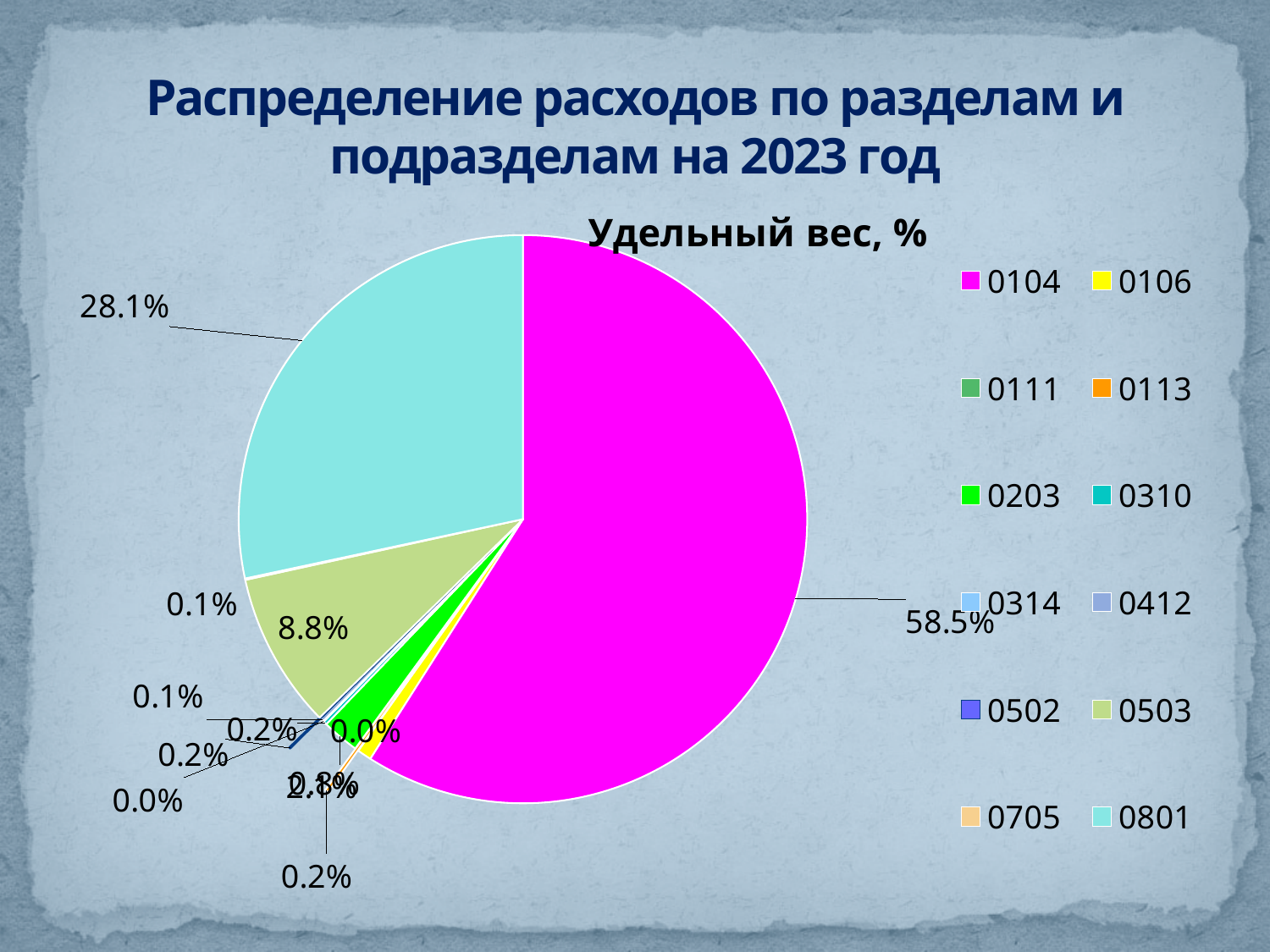
How many categories does the legend of the pie chart list? 12 What is the title of the pie chart? Удельный вес, % By how many percentage points does the share of 0801 exceed the share of 0503? 19.3 What is the value shown for category 0503? 8.8% What type of chart is shown on the slide? pie chart Which is larger, the share of 0801 or the share of 0503? 0801 What colour is the slice for category 0104? magenta What is the value shown for category 0801? 28.1% Which is larger, the share of 0104 or the share of 0801? 0104 What share of the pie does category 0104 have? 58.5% Which category has the largest slice of the pie chart? 0104 By how many percentage points does the share of 0104 exceed the share of 0801? 30.4